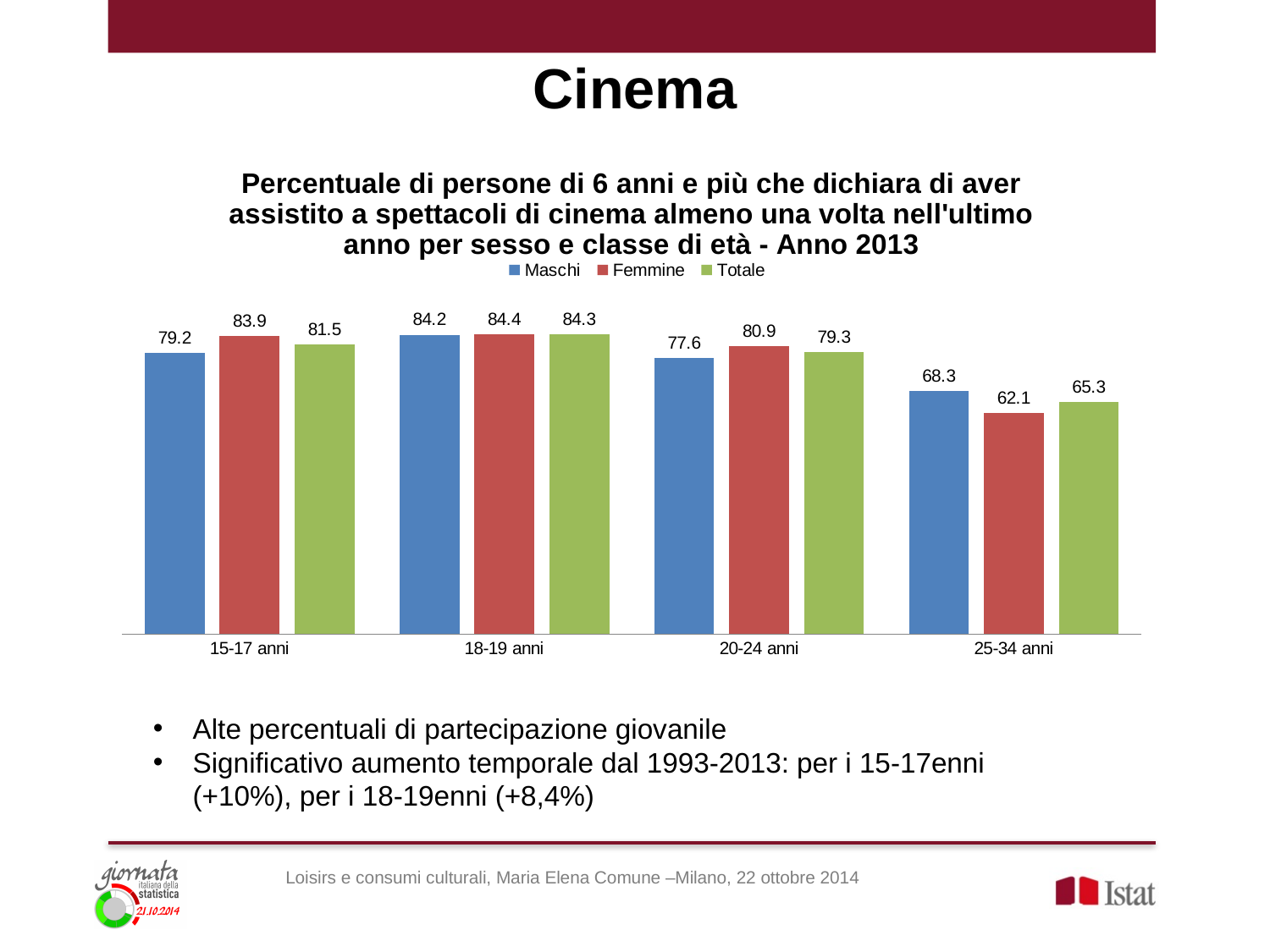
Which age group has the highest Totale value? 18-19 anni What kind of chart is shown on the slide? Bar chart Which age group has the lowest Femmine value? 25-34 anni How many series does the legend list? 3 Which is larger for the 25-34 anni age group, the Maschi value or the Femmine value? Maschi What is the difference between the Femmine and Maschi values for the 20-24 anni age group? 3.3 Does the Totale value rise or fall from the 18-19 anni group to the 25-34 anni group? Fall How many age groups are shown on the x axis? 4 What is the value for Maschi in the 15-17 anni age group? 79.2 What is the Totale value for the 20-24 anni age group? 79.3 What is the value for Femmine in the 25-34 anni age group? 62.1 Which colour represents the Femmine series in the chart? Red